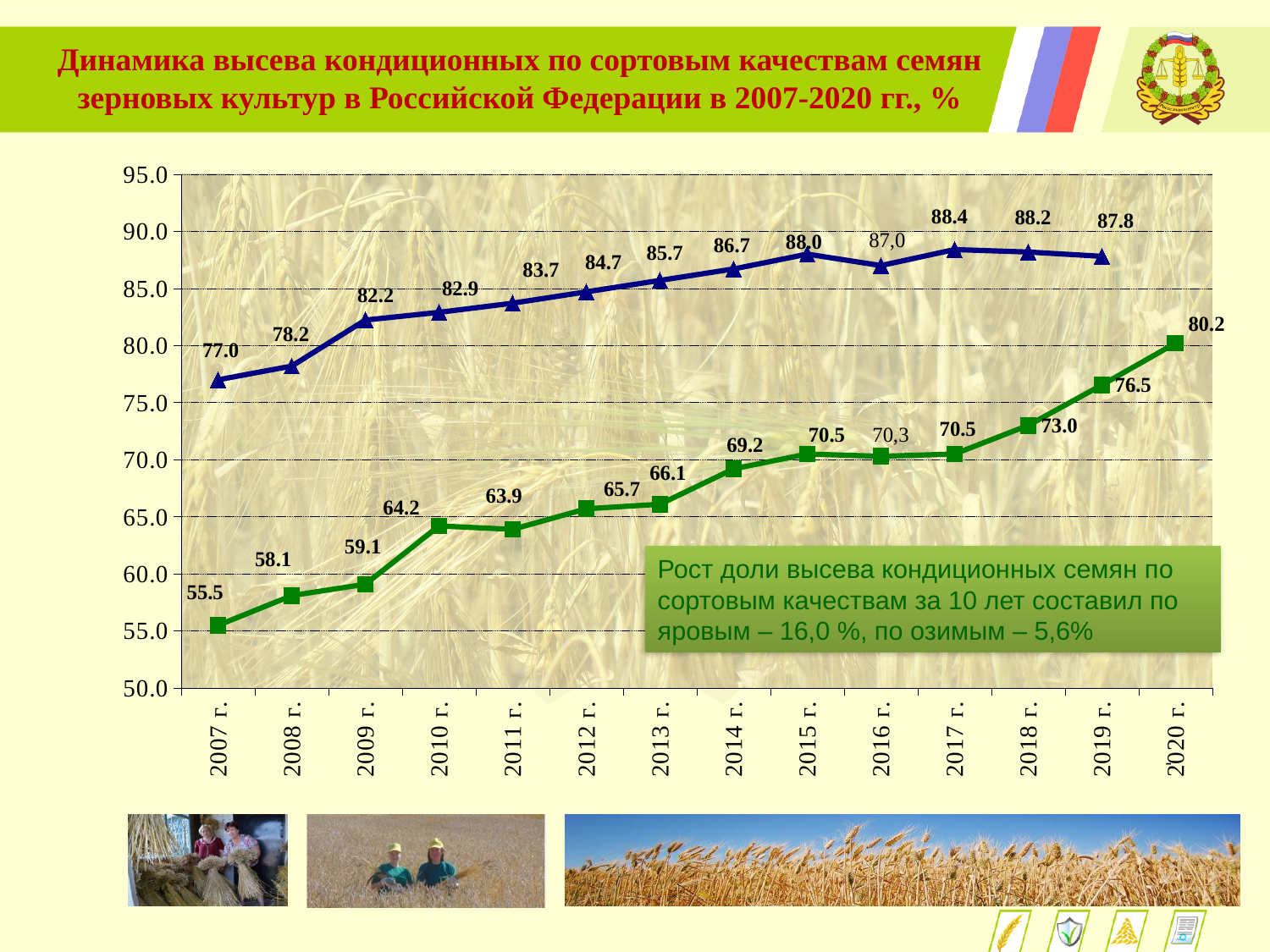
What is the difference between the blue line and the green line in 2007 г.? 21.5 What is the value of the green line for 2020 г.? 80.2 What is the value of the blue line for 2012 г.? 84.7 What is the value of the blue line for 2017 г.? 88.4 In which year does the blue line have its lowest value? 2007 г. Does the green line generally rise or fall from 2007 г. to 2020 г.? rise What is the difference between the green line's values for 2020 г. and 2007 г.? 24.7 In which year does the green line reach its highest value? 2020 г. What is the value of the green line for 2007 г.? 55.5 How many years are shown on the x axis of the chart? 14 Which is larger for the green line: the value for 2010 г. or for 2011 г.? 2010 г. What type of chart is shown on the slide? line chart